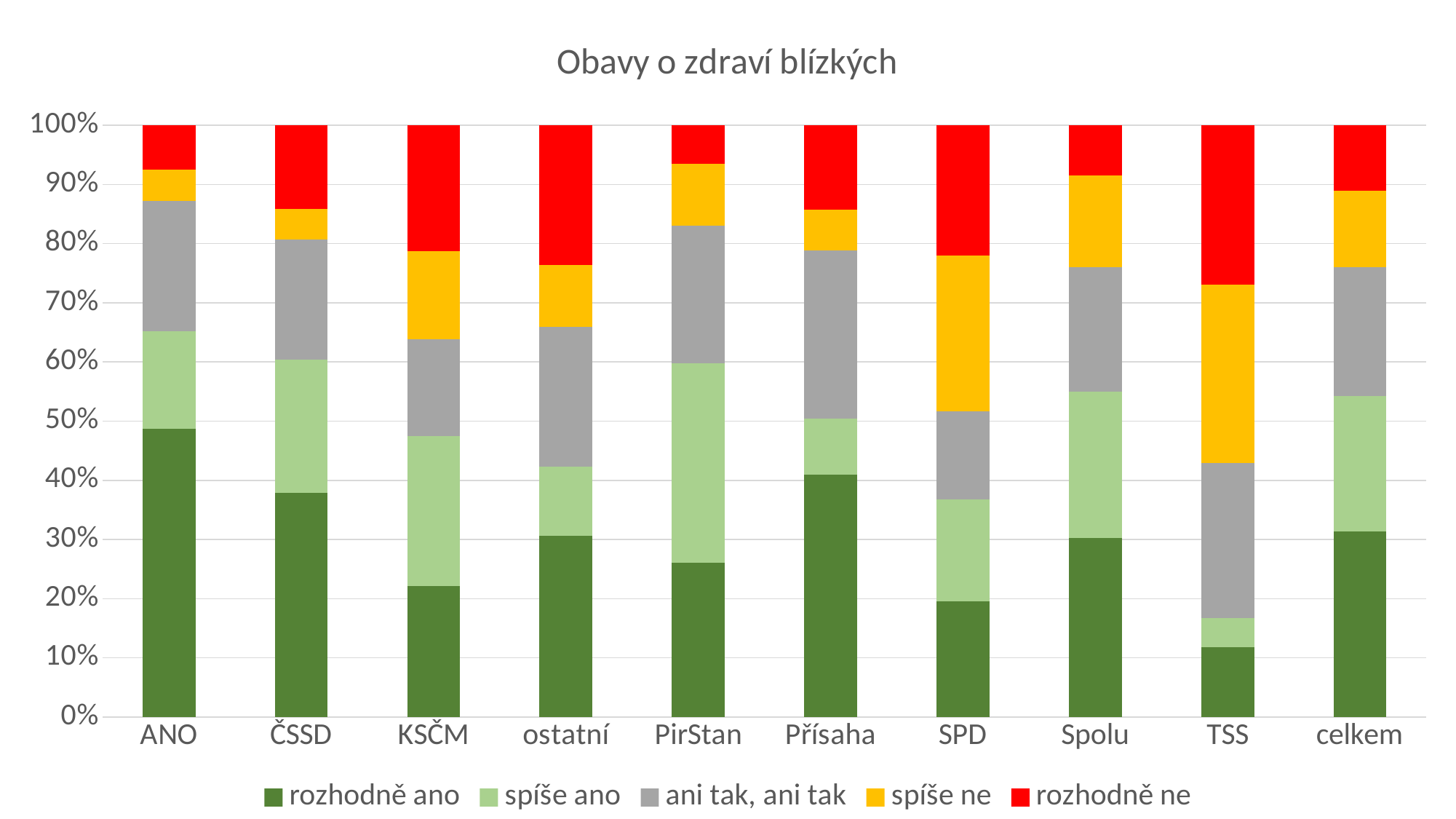
Which category has the lowest share of 'rozhodně ano'? TSS What is the title of the chart? Obavy o zdraví blízkých Is the 'rozhodně ano' value for PirStan greater or less than 30%? less How many series does the legend list? 5 What colour represents 'rozhodně ne' in the legend? red What kind of chart is shown on the slide? stacked bar chart Is the 'rozhodně ano' value for TSS greater or less than 20%? less Which has a larger 'rozhodně ne' share, TSS or PirStan? TSS Which has a larger 'rozhodně ano' share, ČSSD or KSČM? ČSSD Is the 'rozhodně ano' value for ANO greater or less than 40%? greater Which category has the highest share of 'rozhodně ano'? ANO How many categories are shown along the x axis? 10